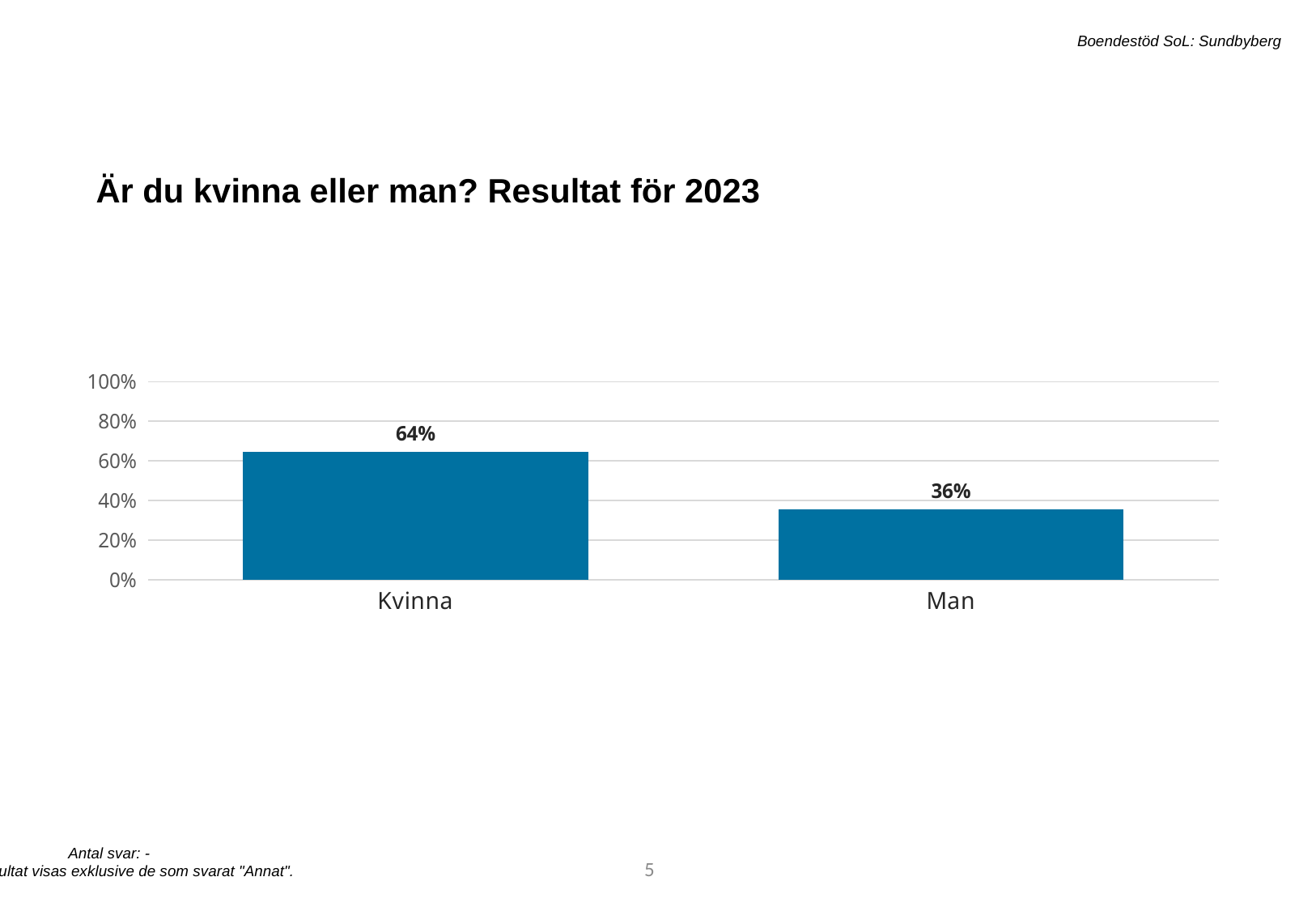
Which category has the lowest value? Man Is the value for Man greater or less than 40%? less What is the value for Kvinna? 64% How many categories are shown on the x axis? 2 What is the total of the values for Kvinna and Man? 100% What kind of chart is shown on the slide? bar chart What is the value for Man? 36% Is the value for Kvinna greater or less than 60%? greater Which is larger, the value for Kvinna or the value for Man? Kvinna What is the difference between the values for Kvinna and Man? 28% What is the title of the chart? Är du kvinna eller man? Resultat för 2023 Which category has the highest value? Kvinna